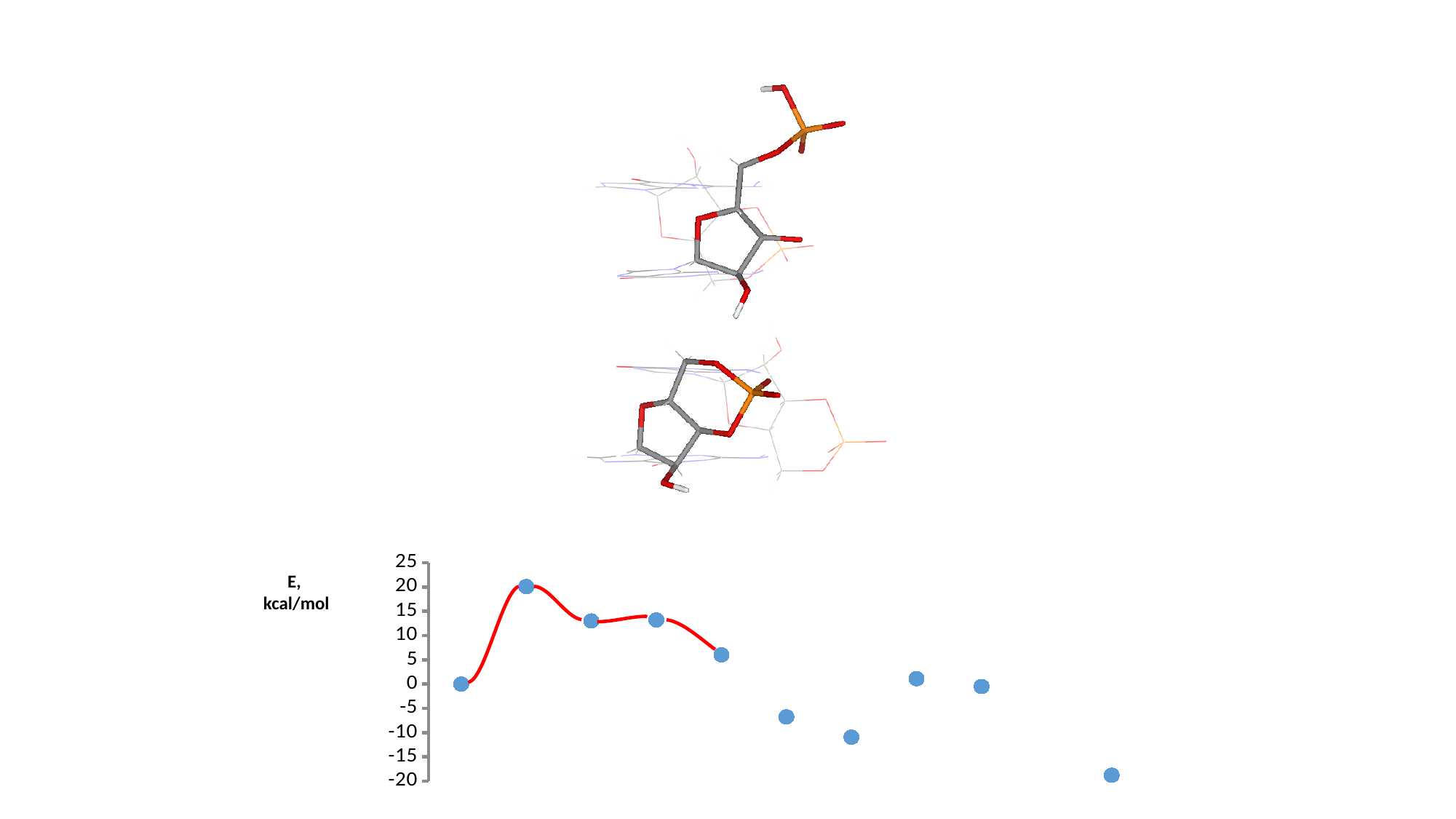
Is the value of the seventh point from the left greater or less than -5? less Is the value of the last point on the right greater or less than -15? less Is the value of the second point from the left greater or less than 15? greater Which point has the highest energy value: the second point from the left or the last point on the right? the second point from the left What is the label on the vertical axis of the chart? E, kcal/mol Which data point has the highest energy value in the chart? the second point from the left What is the highest value shown on the vertical axis of the chart? 25 Which data point has the lowest energy value in the chart? the last point on the right How many data points are plotted in the chart? 10 What kind of chart is shown at the bottom of the slide? scatter chart